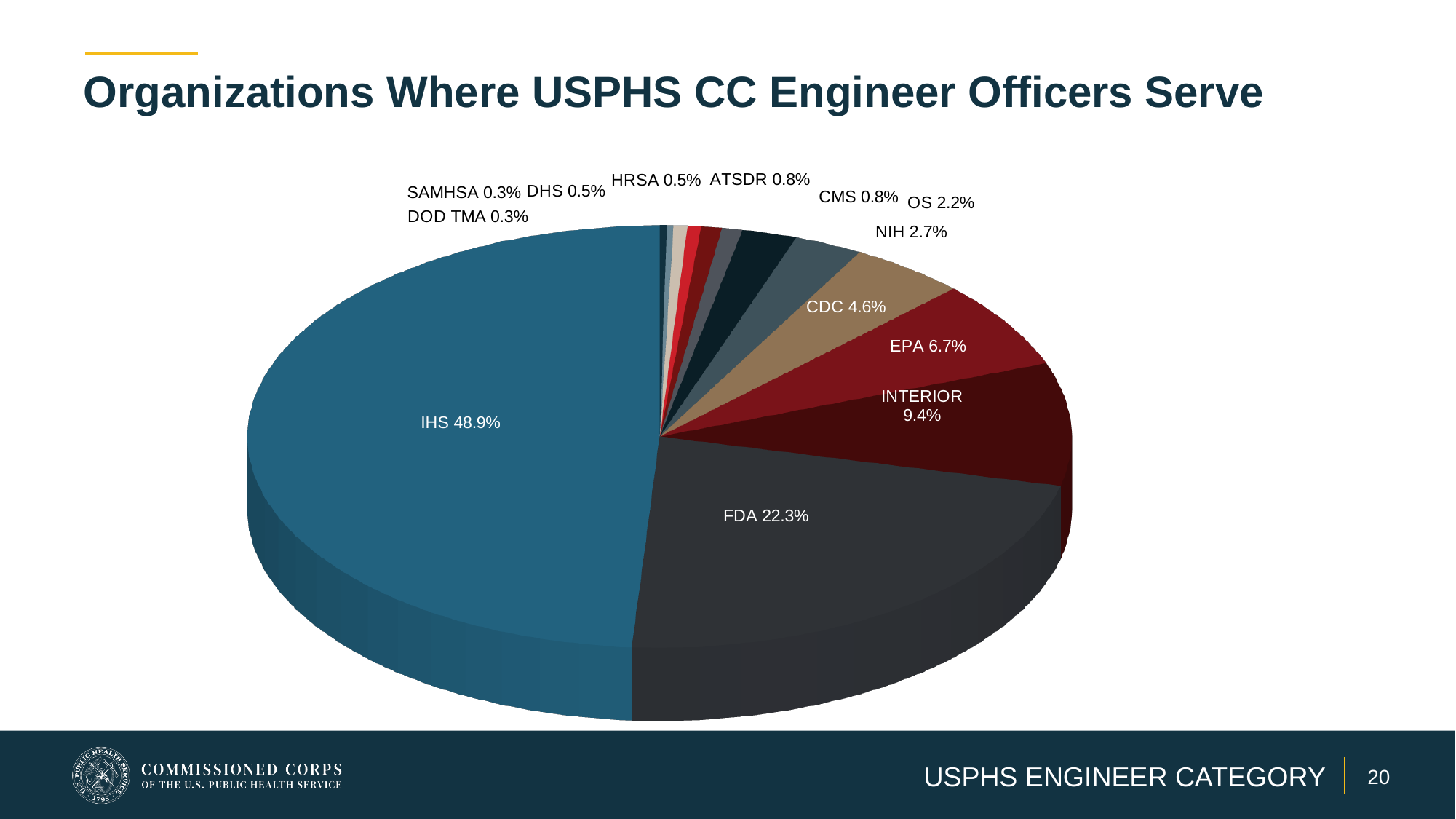
What percentage is shown for OS? 2.2% What is the difference in percentage points between IHS and FDA? 26.6 What share of USPHS CC Engineer Officers serve at IHS? 48.9% What is the title of the chart on the slide? Organizations Where USPHS CC Engineer Officers Serve What percentage is shown for FDA? 22.3% How many organizations are labeled on the pie chart? 13 What percentage is shown for INTERIOR? 9.4% What kind of chart is shown on the slide? Pie chart What percentage is shown for CDC? 4.6% What is the combined share of EPA and CDC? 11.3% Which organization has the largest slice of the pie? IHS Which is larger, the share for EPA or the share for NIH? EPA